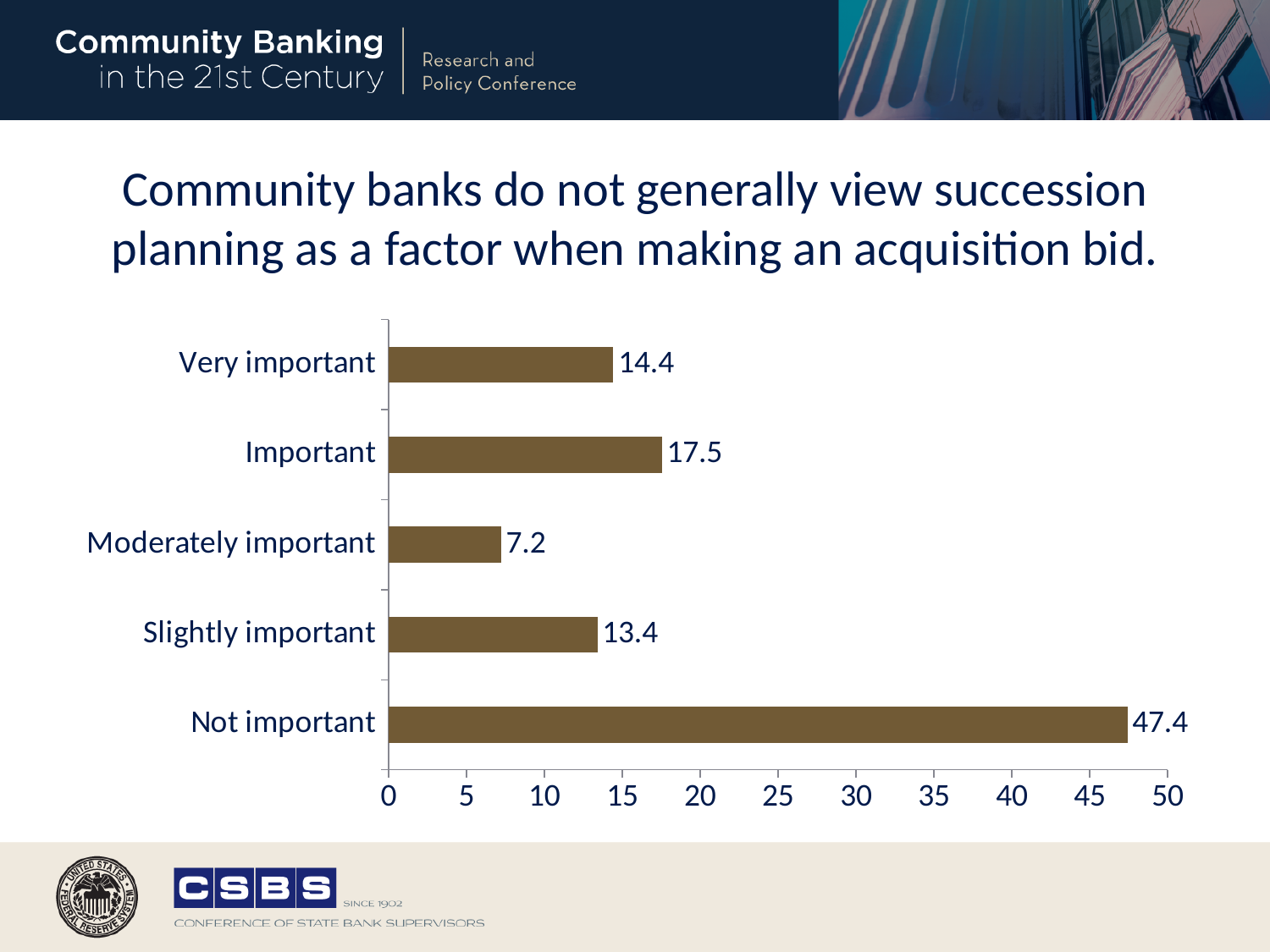
What is the value for Moderately important? 7.2 What is the value for Not important? 47.4 What is the value for Very important? 14.4 Which category has the highest value? Not important What is the difference between the values for Very important and Slightly important? 1.0 What kind of chart is shown on the slide? Bar chart Which is larger, the value for Important or the value for Very important? Important What is the difference between the values for Not important and Important? 29.9 How many categories are shown in the chart? 5 Which category has the lowest value? Moderately important What is the value for Important? 17.5 What is the maximum value shown on the horizontal axis? 50